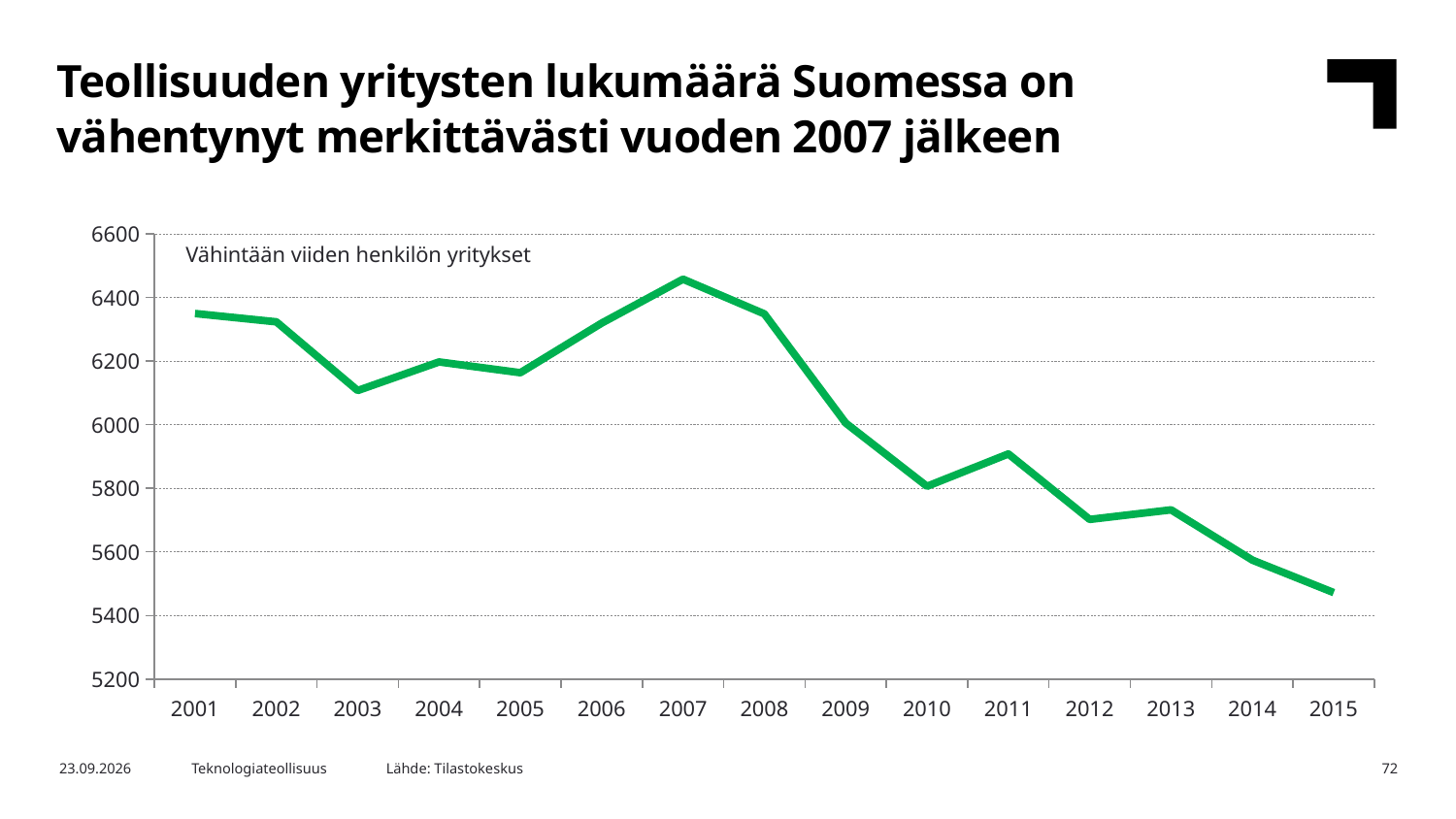
Is the value for 2003 greater or less than 6200? less Is the value for 2015 greater or less than 5600? less Do the values rise or fall from 2007 to 2015? fall Is the value for 2007 greater or less than 6400? greater In which year is the number of industrial companies highest? 2007 How many years are plotted along the x axis? 15 Which year has a higher value, 2001 or 2012? 2001 In which year is the number of industrial companies lowest? 2015 What kind of chart is shown on the slide? line chart What text label is shown inside the plot area of the chart? Vähintään viiden henkilön yritykset